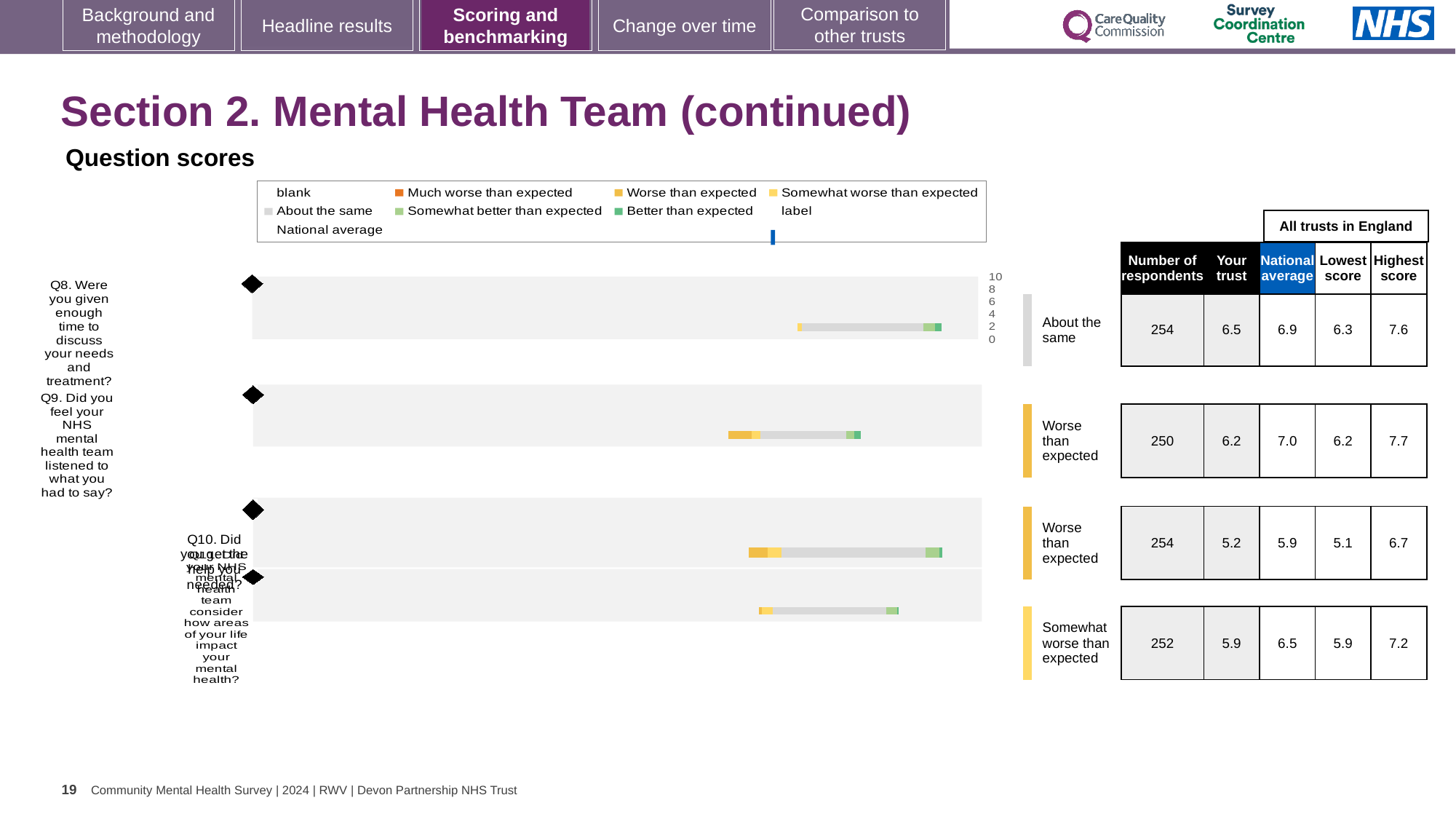
Which question has the highest 'Your trust' score? Q8 What is the national average score for Q10 (Did you get the help you needed?)? 5.9 What benchmark category is shown for Q10 (Did you get the help you needed?)? Worse than expected How many respondents are shown for Q9 (Did you feel your NHS mental health team listened to what you had to say?)? 250 What is the 'Your trust' score for Q8 (Were you given enough time to discuss your needs and treatment?)? 6.5 How many questions (bars) are plotted in the question scores chart? 4 Which question has the lowest 'Your trust' score? Q10 For Q9, how much higher is the national average than the 'Your trust' score? 0.8 How many entries does the legend of the question scores chart list? 9 What kind of chart is used to show the question scores on this slide? bar chart For Q8, which is larger: the 'Your trust' score or the national average? National average What is the highest score among all trusts in England for Q8? 7.6